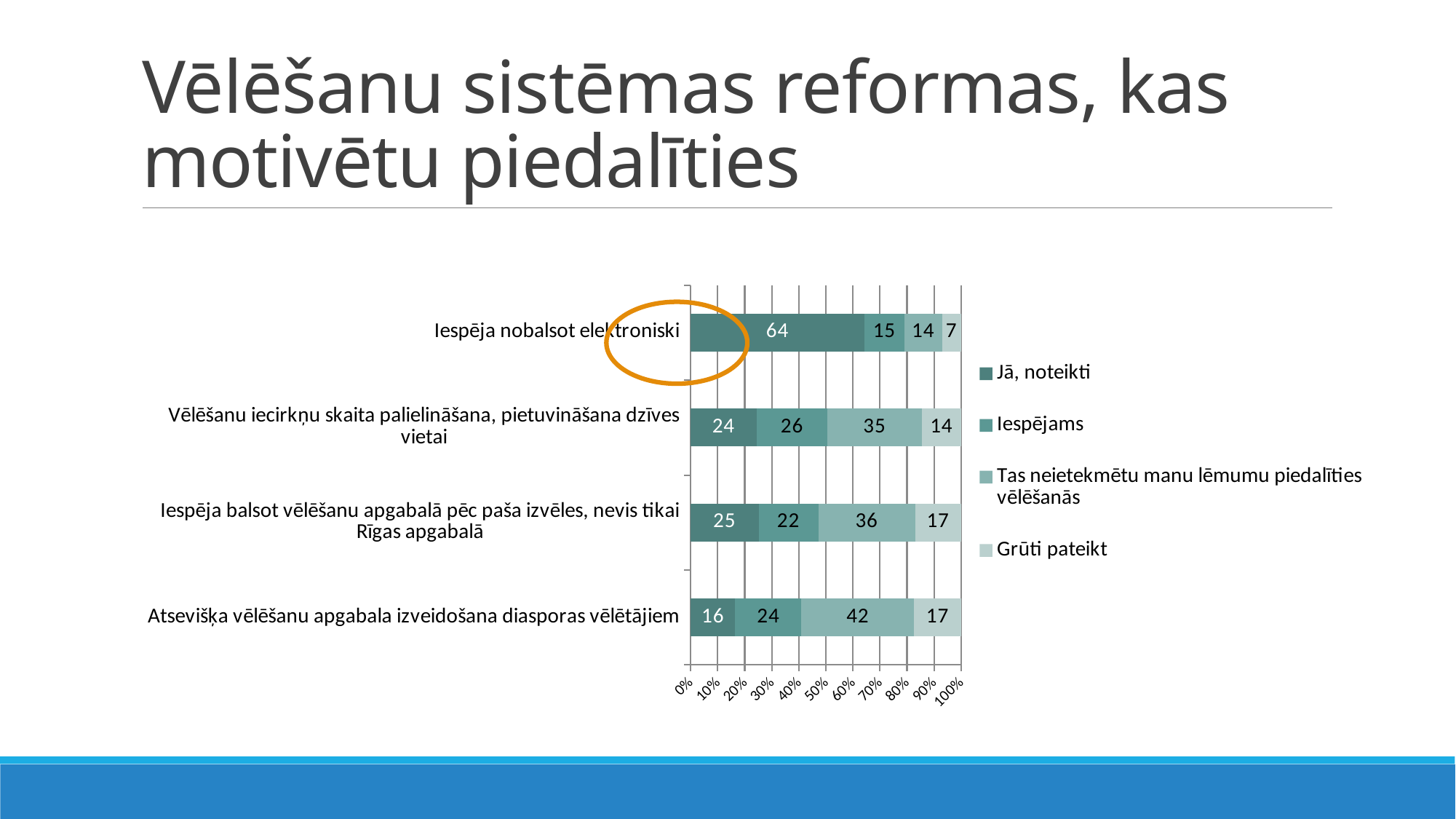
Which is larger: the "Tas neietekmētu manu lēmumu piedalīties vēlēšanās" value for "Atsevišķa vēlēšanu apgabala izveidošana diasporas vēlētājiem" or for "Vēlēšanu iecirkņu skaita palielināšana, pietuvināšana dzīves vietai"? Atsevišķa vēlēšanu apgabala izveidošana diasporas vēlētājiem How many series does the legend list? 4 What is the "Tas neietekmētu manu lēmumu piedalīties vēlēšanās" value for "Atsevišķa vēlēšanu apgabala izveidošana diasporas vēlētājiem"? 42 What is the total of the stacked bar for "Iespēja nobalsot elektroniski"? 100 Which category has the highest "Jā, noteikti" value? Iespēja nobalsot elektroniski What is the "Jā, noteikti" value for "Iespēja nobalsot elektroniski"? 64 What kind of chart is shown on the slide? Stacked bar chart What is the "Grūti pateikt" value for "Vēlēšanu iecirkņu skaita palielināšana, pietuvināšana dzīves vietai"? 14 What is the "Iespējams" value for "Iespēja balsot vēlēšanu apgabalā pēc paša izvēles, nevis tikai Rīgas apgabalā"? 22 How many categories are shown on the chart? 4 Which category has the lowest "Jā, noteikti" value? Atsevišķa vēlēšanu apgabala izveidošana diasporas vēlētājiem What is the difference between the "Jā, noteikti" values for "Iespēja nobalsot elektroniski" and "Atsevišķa vēlēšanu apgabala izveidošana diasporas vēlētājiem"? 48